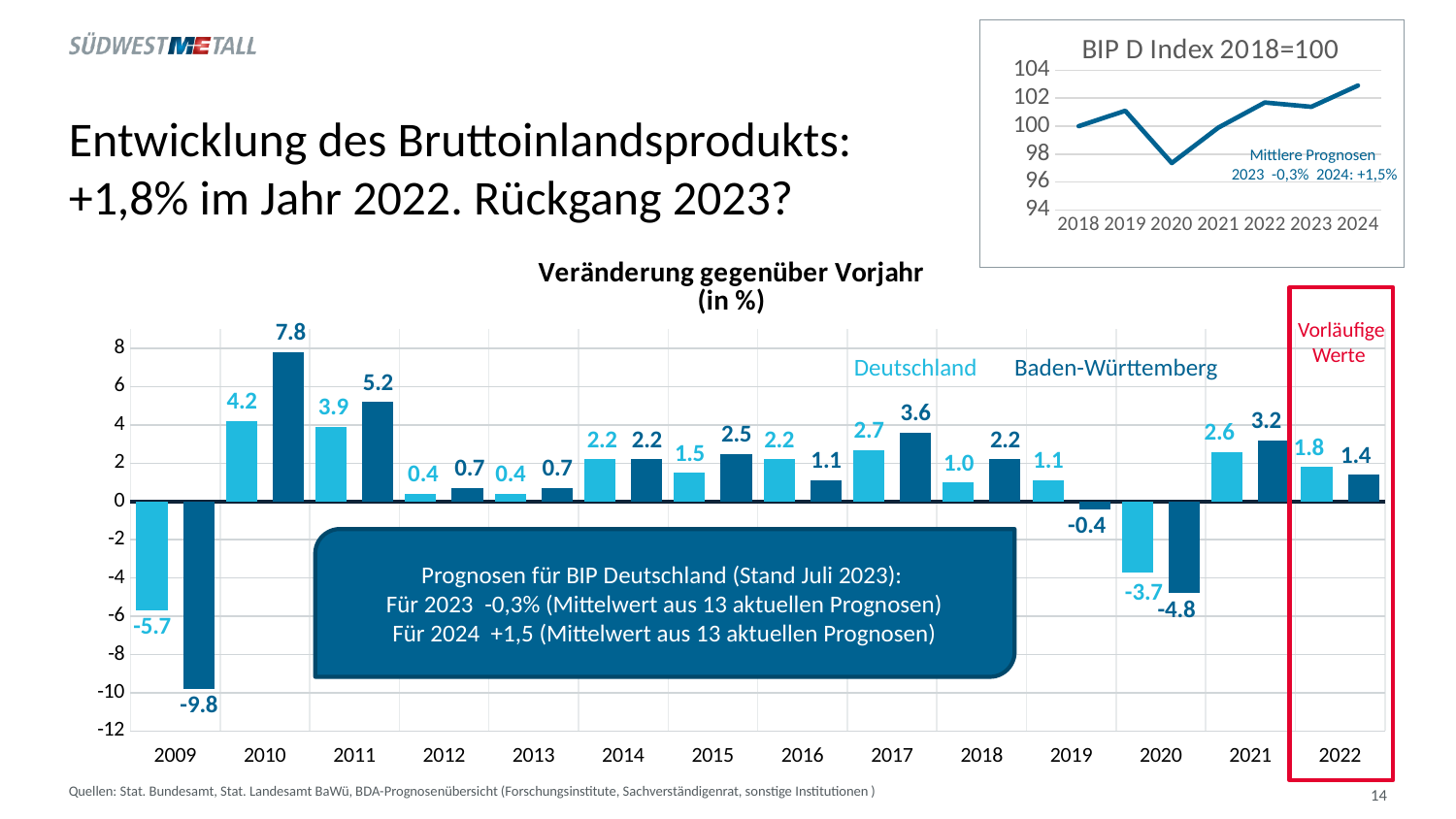
How many years are shown on the x axis of the bar chart 'Veränderung gegenüber Vorjahr (in %)'? 14 How many series does the legend of the bar chart 'Veränderung gegenüber Vorjahr (in %)' list? 2 What kind of chart is the chart titled 'BIP D Index 2018=100' in the top right? line chart In the bar chart 'Veränderung gegenüber Vorjahr (in %)', what is the difference between the Baden-Württemberg and Deutschland values in 2017? 0.9 In the bar chart 'Veränderung gegenüber Vorjahr (in %)', which year has the lowest value for Baden-Württemberg? 2009 In the line chart 'BIP D Index 2018=100', is the value for 2024 greater or less than 102? greater In the bar chart 'Veränderung gegenüber Vorjahr (in %)', which is larger in 2016: Deutschland or Baden-Württemberg? Deutschland In the bar chart 'Veränderung gegenüber Vorjahr (in %)', what is the value for Baden-Württemberg in 2022? 1.4 In the bar chart 'Veränderung gegenüber Vorjahr (in %)', which year has the highest value for Deutschland? 2010 In the bar chart 'Veränderung gegenüber Vorjahr (in %)', what is the value for Baden-Württemberg in 2010? 7.8 In the line chart 'BIP D Index 2018=100', is the value for 2020 greater or less than 98? less In the bar chart 'Veränderung gegenüber Vorjahr (in %)', what is the value for Deutschland in 2020? -3.7